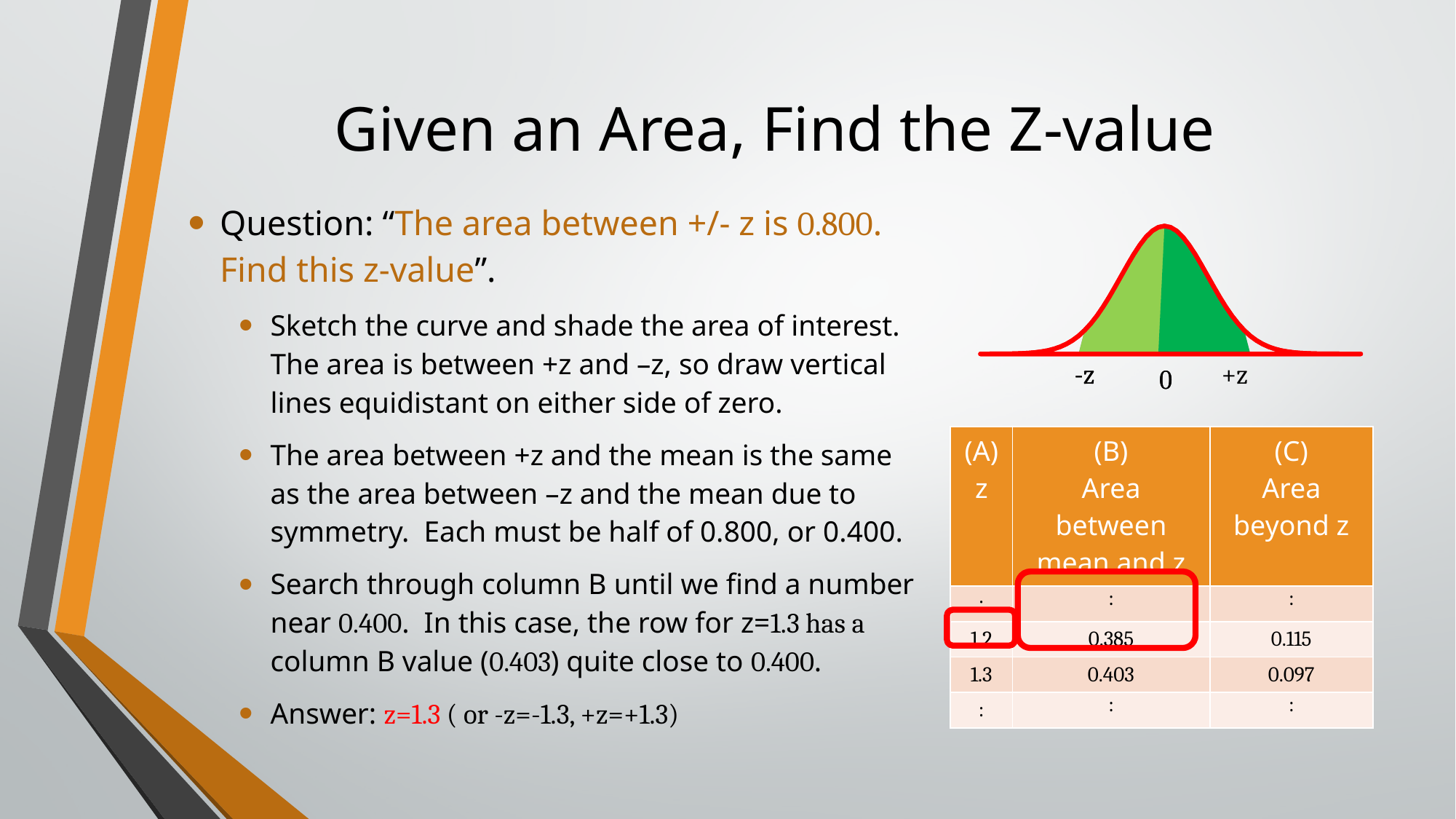
In the table, what is the area beyond z for z = 1.3? 0.097 How many columns does the table have? 3 In the table, what is the column B value (area between mean and z) for z = 1.3? 0.403 In the curve chart, what colour is the shaded region between 0 and +z? Dark green In the table, what is the area between mean and z for z = 1.2? 0.385 In the table, what is the column C value (area beyond z) for z = 1.2? 0.115 In the table, what is the difference between the column B values for z = 1.3 and z = 1.2? 0.018 What kind of chart is shown at the top right of the slide? A bell curve (normal distribution curve) with a shaded area In the table, what is the difference between the column C values for z = 1.2 and z = 1.3? 0.018 What three labels appear along the horizontal axis of the curve chart? -z, 0, +z How many labelled points are marked on the horizontal axis of the curve chart? 3 In the table, which z-value has the larger area between mean and z, 1.2 or 1.3? 1.3